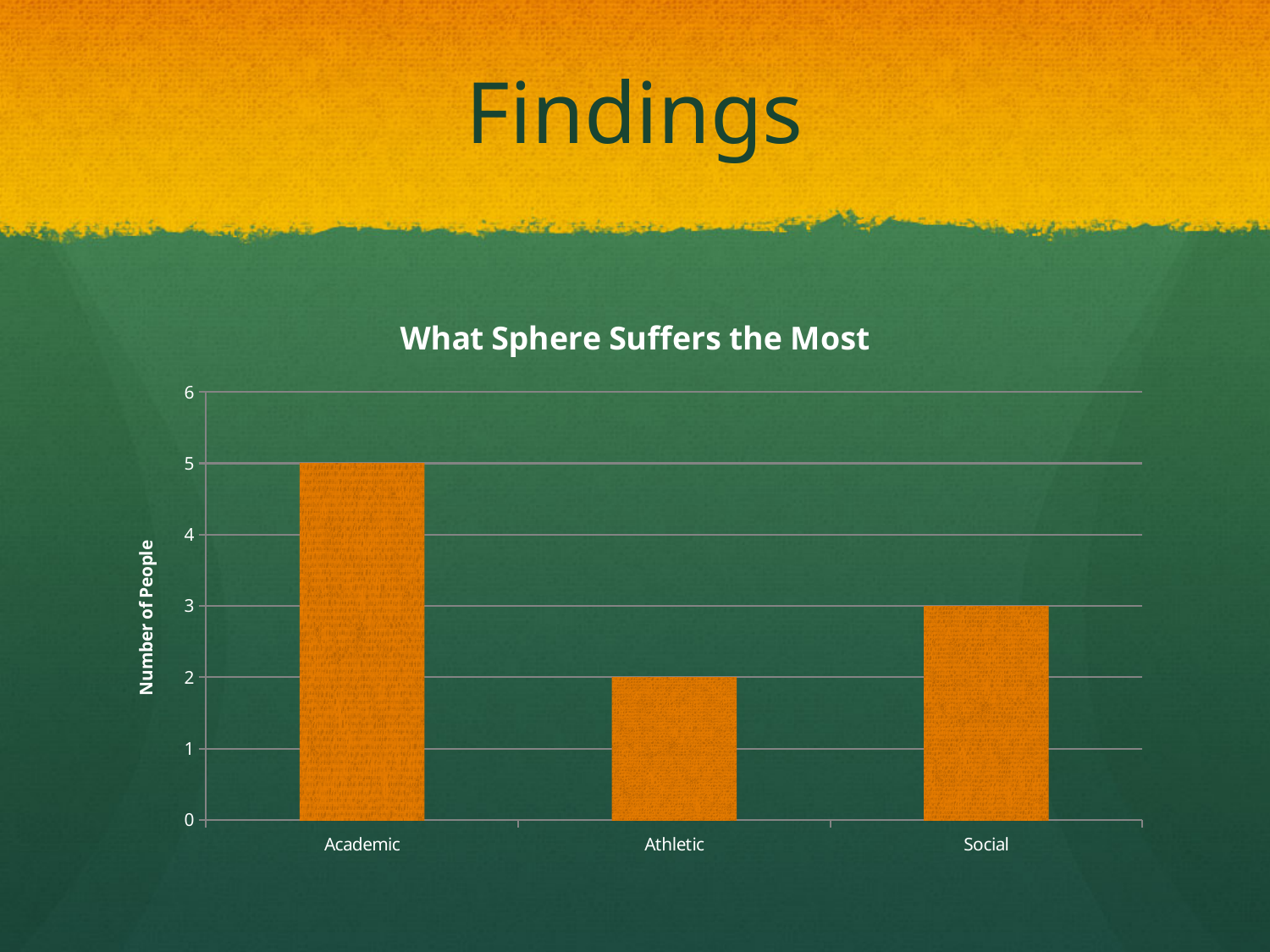
What is the title of the chart? What Sphere Suffers the Most How many categories are shown on the x axis? 3 What is the difference between the values for Social and Athletic? 1 Which is larger, the value for Social or the value for Athletic? Social What is the value for Social? 3 Which category has the highest number of people? Academic What kind of chart is shown? bar chart What is the value for Athletic? 2 Is the value for Academic greater or less than 4? greater What is the value for Academic? 5 Which category has the lowest number of people? Athletic What is the difference between the values for Academic and Athletic? 3